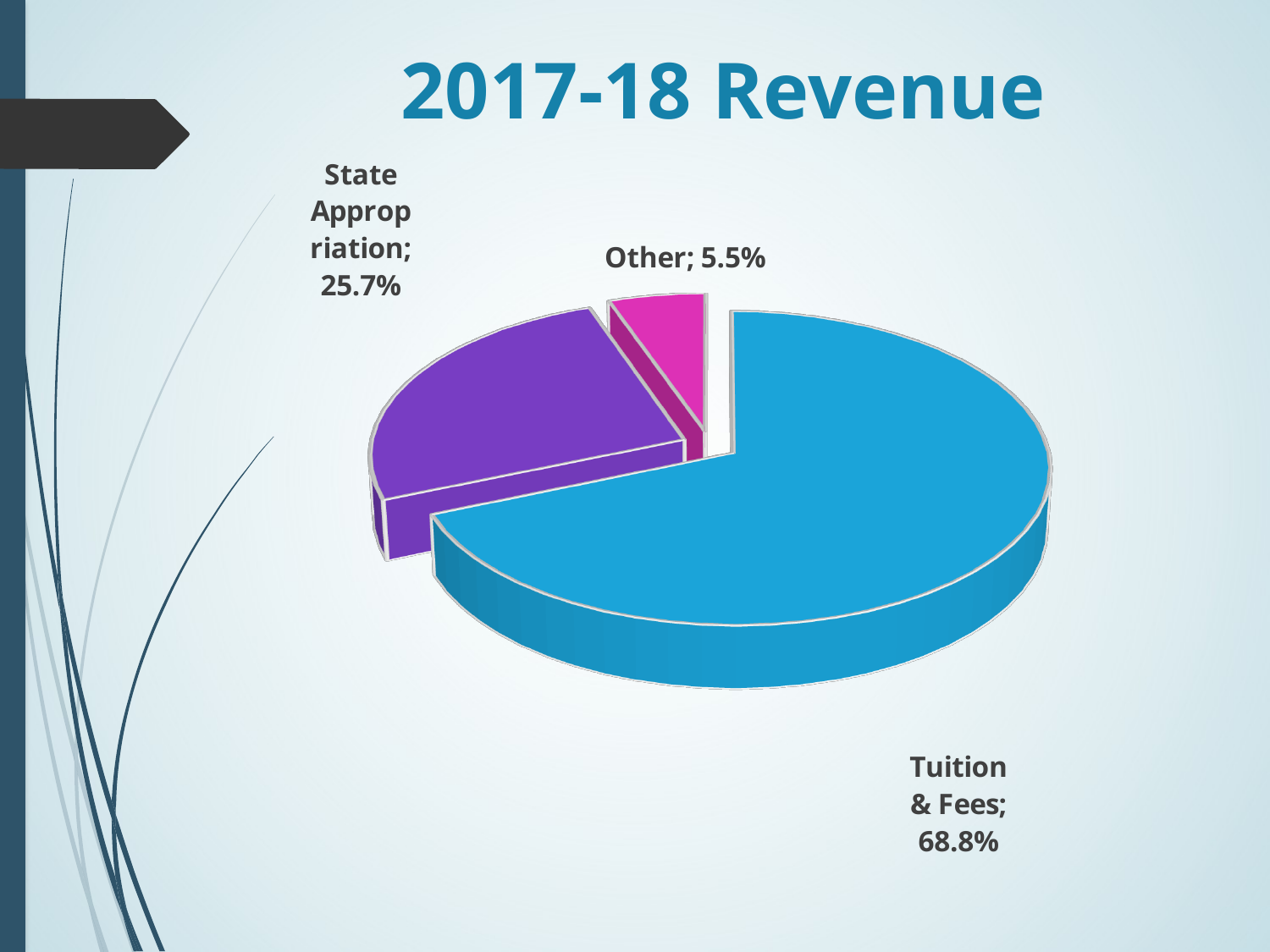
What kind of chart is shown on the slide? Pie chart How many percentage points larger is the State Appropriation share than the Other share? 20.2 What share of 2017-18 revenue comes from Tuition & Fees? 68.8% What share of 2017-18 revenue comes from State Appropriation? 25.7% What colour is the Tuition & Fees slice? Blue What share of 2017-18 revenue is labelled Other? 5.5% Which is larger, the State Appropriation share or the Other share? State Appropriation What is the title of the chart? 2017-18 Revenue Which revenue source has the largest share? Tuition & Fees Which revenue source has the smallest share? Other How many percentage points larger is the Tuition & Fees share than the State Appropriation share? 43.1 How many slices does the pie chart have? 3